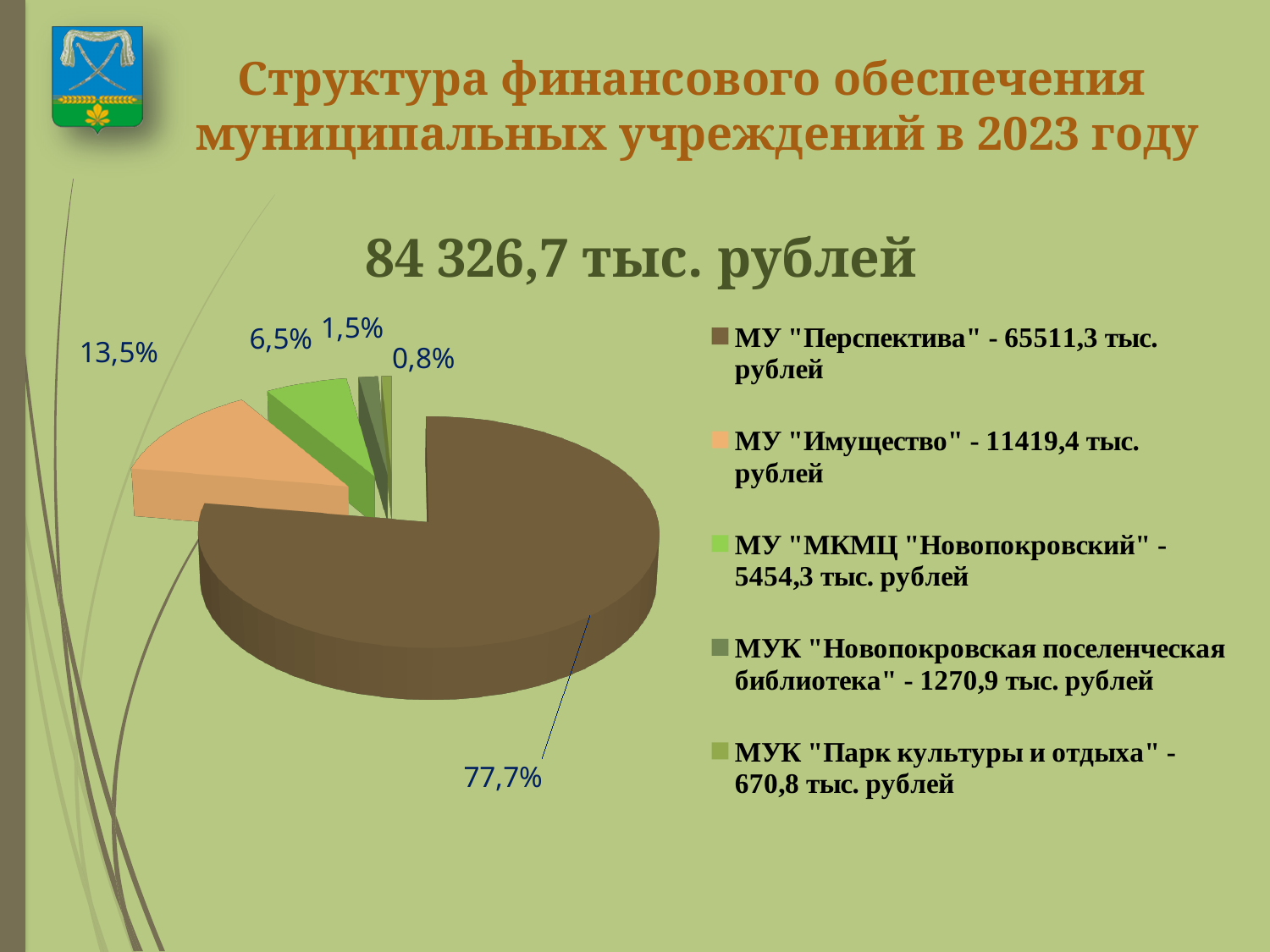
Which category has the smallest slice of the pie? МУК "Парк культуры и отдыха" What share of the pie does МУ "Имущество" account for? 13,5% What total amount is stated above the pie chart? 84 326,7 тыс. рублей What is the value shown in the legend for МУК "Новопокровская поселенческая библиотека"? 1270,9 тыс. рублей What type of chart is shown on the slide? Pie chart How many categories does the pie chart have? 5 What share of the pie does МУ "Перспектива" account for? 77,7% What share of the pie does МУ "МКМЦ "Новопокровский" account for? 6,5% Which is larger: the value for МУ "МКМЦ "Новопокровский" or МУК "Новопокровская поселенческая библиотека"? МУ "МКМЦ "Новопокровский" What is the difference between the values for МУ "Перспектива" and МУ "Имущество" in тыс. рублей? 54091,9 What is the value shown in the legend for МУК "Парк культуры и отдыха"? 670,8 тыс. рублей Which category has the largest slice of the pie? МУ "Перспектива"